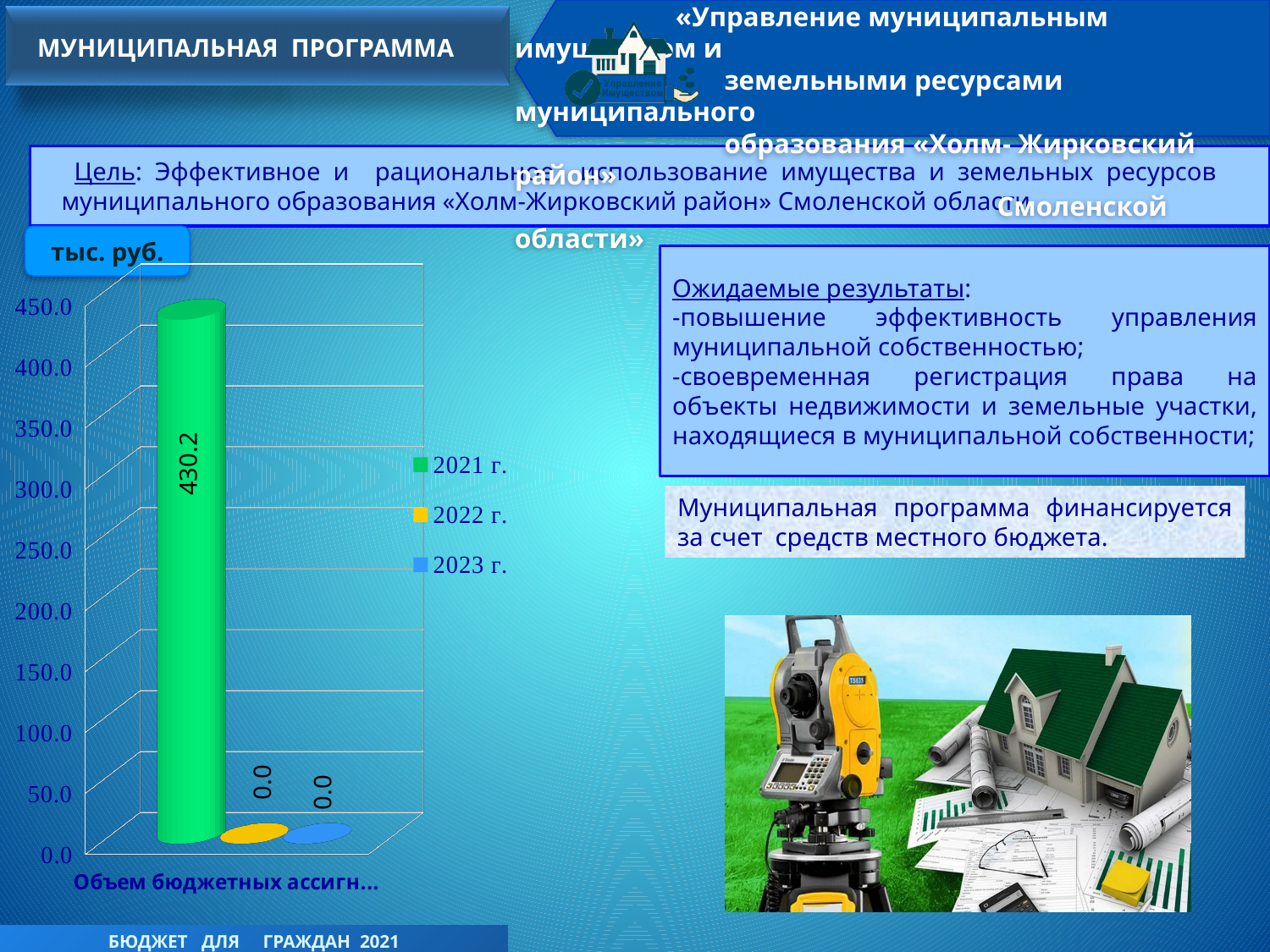
What is the difference between the 2021 г. value and the 2022 г. value? 430.2 What is the value for the 2022 г. series on the chart? 0.0 Is the value for 2021 г. greater or less than 400.0? greater What is the value for the 2023 г. series on the chart? 0.0 What is the value for the 2021 г. series on the chart? 430.2 What colour is the bar for the 2021 г. series? green What unit is shown in the label above the chart? тыс. руб. What kind of chart is shown on the slide? bar chart Is the value for 2021 г. greater or less than 450.0? less Which is larger, the value for 2021 г. or the value for 2023 г.? 2021 г. Which series has the highest value on the chart? 2021 г. How many series does the chart legend list? 3